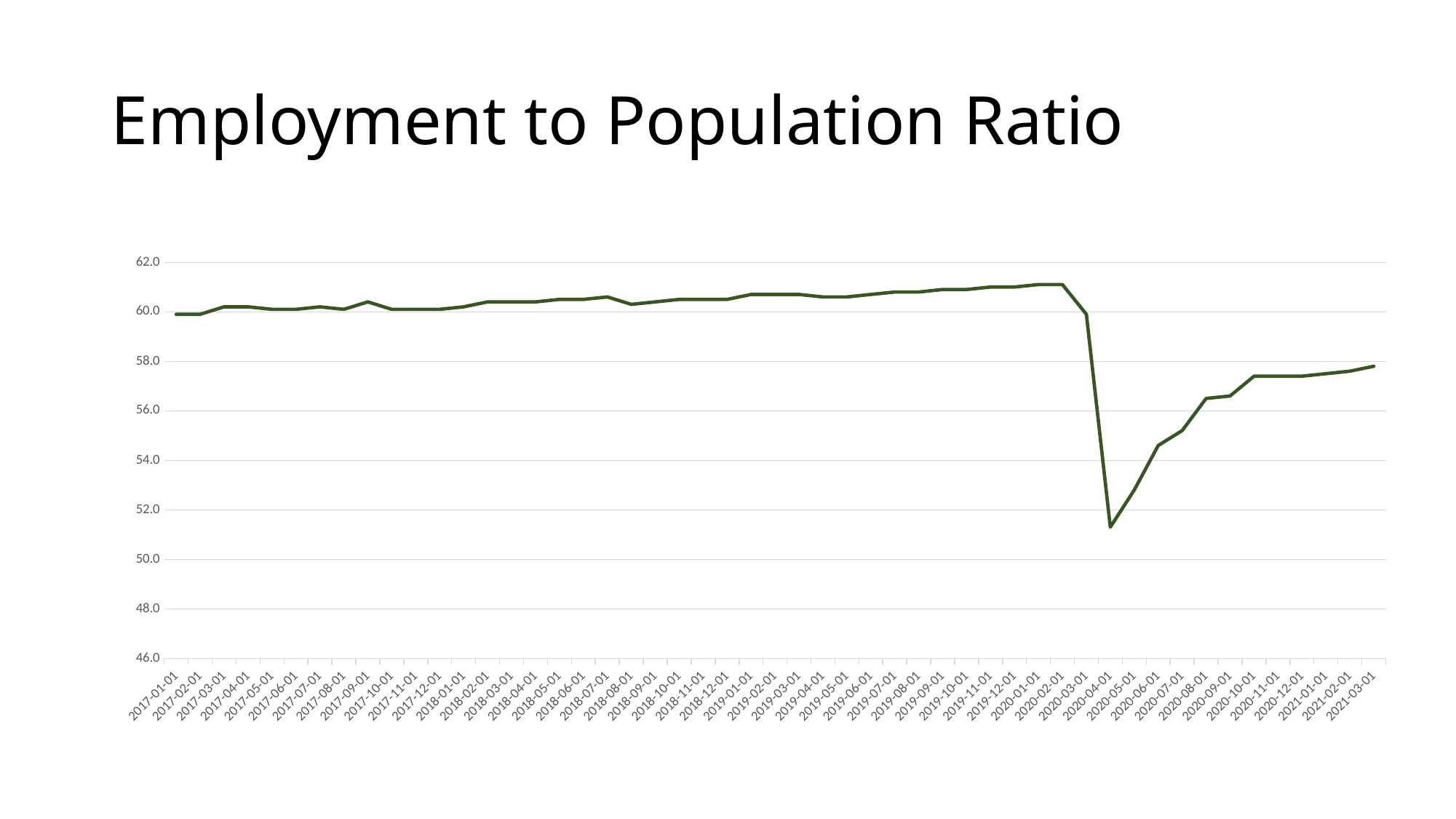
Is the value for 2020-06-01 greater or less than 54.0? greater What is the title of the chart? Employment to Population Ratio Which date has the lowest employment to population ratio? 2020-04-01 Is the value for 2020-10-01 greater or less than 56.0? greater Is the value for 2020-04-01 greater or less than 52.0? less How many monthly data points are plotted on the chart? 51 Which is larger, the value for 2017-01-01 or the value for 2021-03-01? 2017-01-01 Do the values rise or fall from 2020-04-01 to 2021-03-01? rise Which is larger, the value for 2020-04-01 or the value for 2020-05-01? 2020-05-01 What kind of chart is shown on the slide? line chart